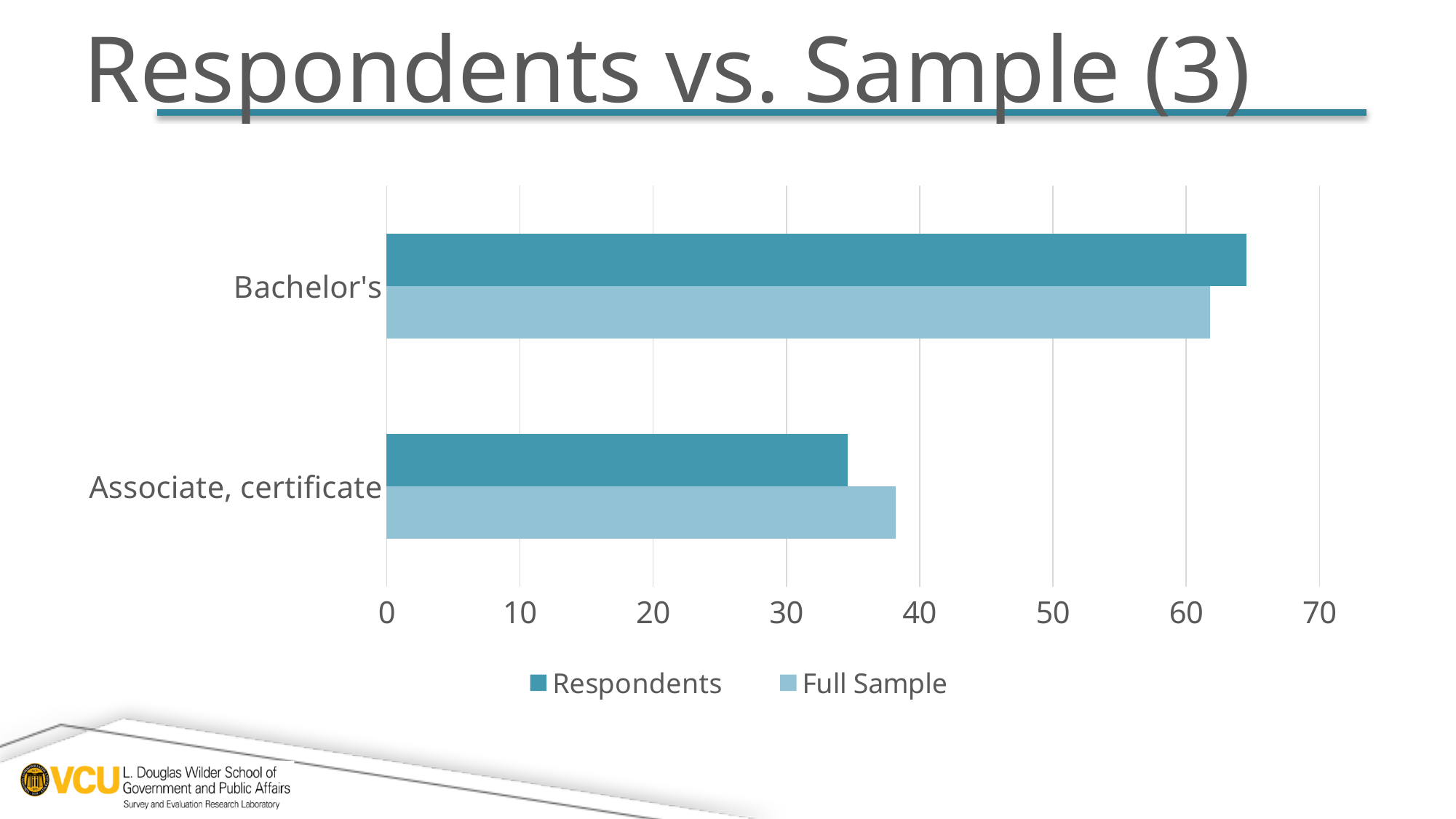
What is the title of the slide containing the chart? Respondents vs. Sample (3) Is the Respondents value for Associate, certificate greater or less than 40? less For Bachelor's, which series has the larger value, Respondents or Full Sample? Respondents Which category has the highest Respondents value? Bachelor's What are the two series named in the legend? Respondents and Full Sample How many series does the legend list? 2 Is the Full Sample value for Associate, certificate greater or less than 30? greater Is the Respondents value for Bachelor's greater or less than 60? greater For Associate, certificate, which series has the larger value, Respondents or Full Sample? Full Sample How many categories are shown on the y axis of the chart? 2 What kind of chart is shown on the slide? bar chart